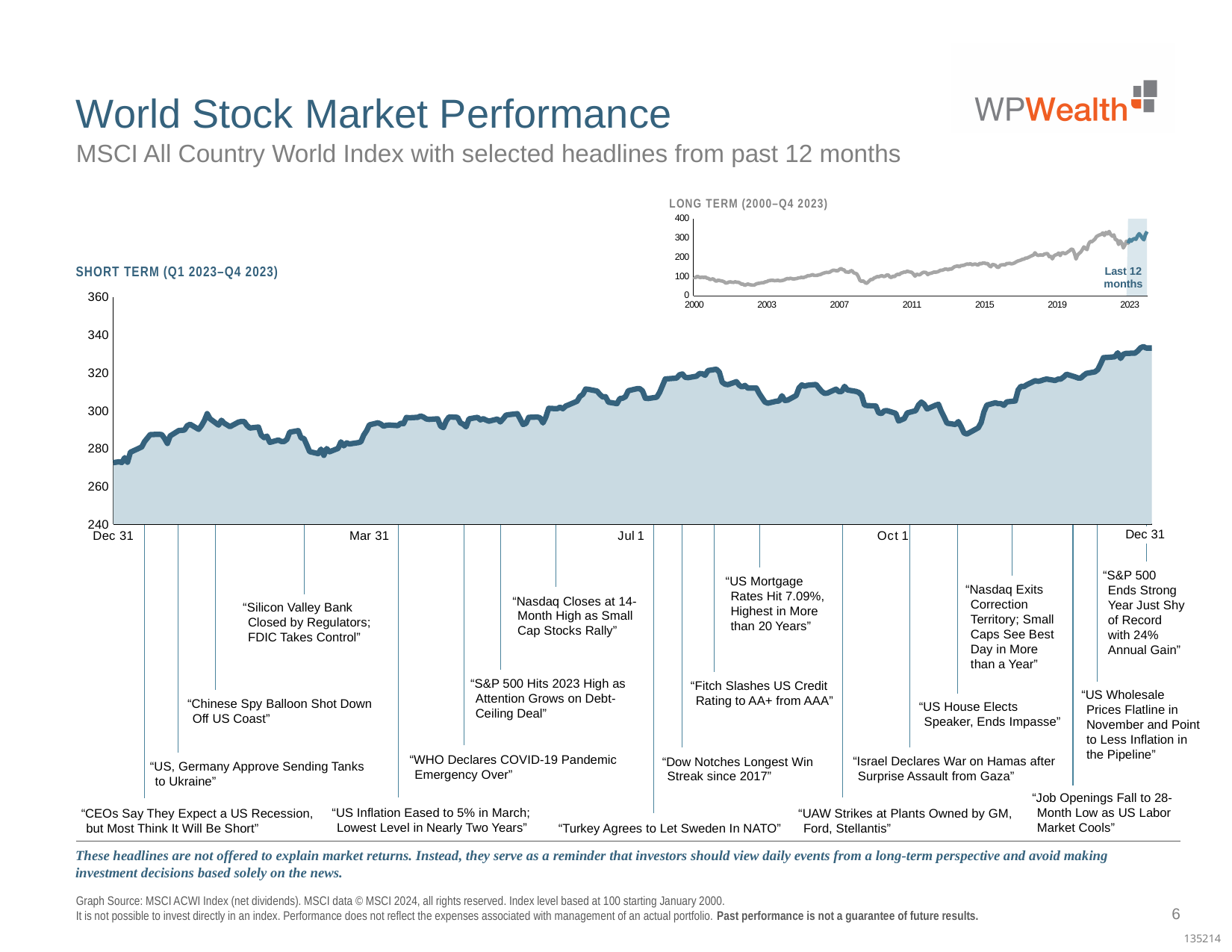
What is the title of the smaller chart in the upper right of the slide? LONG TERM (2000–Q4 2023) On the short-term chart, is the index value at the starting Dec 31 greater or less than 280? less On the long-term chart, is the index value at the end of 2023 greater or less than 300? greater On the long-term chart, what does the shaded region at the right end represent? Last 12 months On the short-term chart, does the index end the year higher or lower than it started? higher On the long-term chart, is the index value in 2003 greater or less than 100? less What is the highest value shown on the y-axis of the short-term chart? 360 What kind of chart is the short-term chart (Q1 2023–Q4 2023)? line chart On the long-term chart, does the index generally rise or fall from 2000 to 2023? rise What kind of chart is the long-term chart (2000–Q4 2023)? line chart